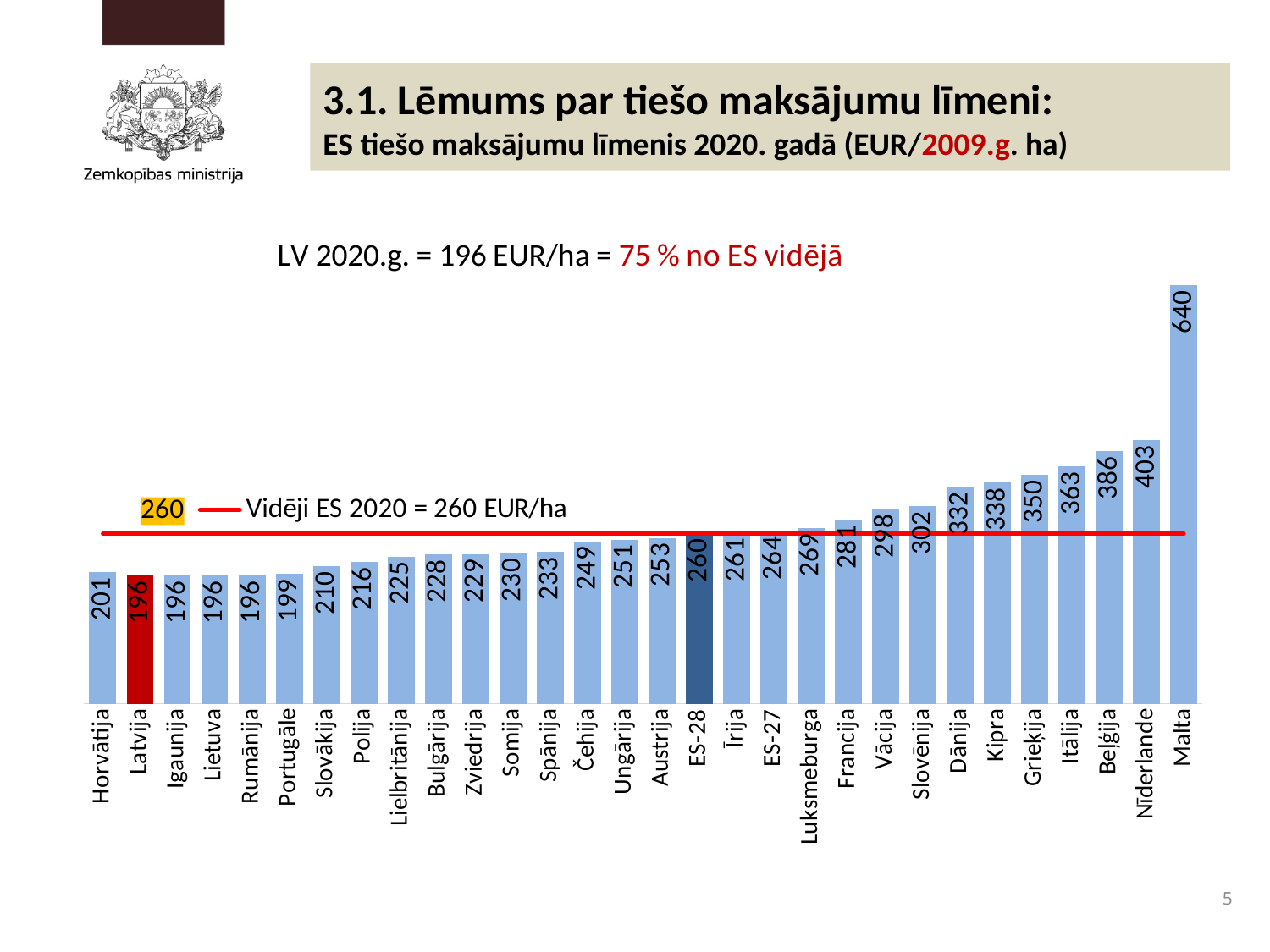
What is the value for Vācija? 298 What kind of chart is shown on the slide? bar chart Which is larger, the value for Francija or the value for Luksemburga? Francija What value does the red horizontal line (Vidēji ES 2020) mark? 260 EUR/ha What is the value for Malta? 640 Which category has the highest value? Malta What is the value for Latvija? 196 Do the values generally rise or fall from left to right along the x axis? rise What is the difference between the values for ES-28 and Latvija? 64 What is the difference between the values for Malta and Nīderlande? 237 What is the value for ES-28? 260 How many bars are shown in the chart? 30